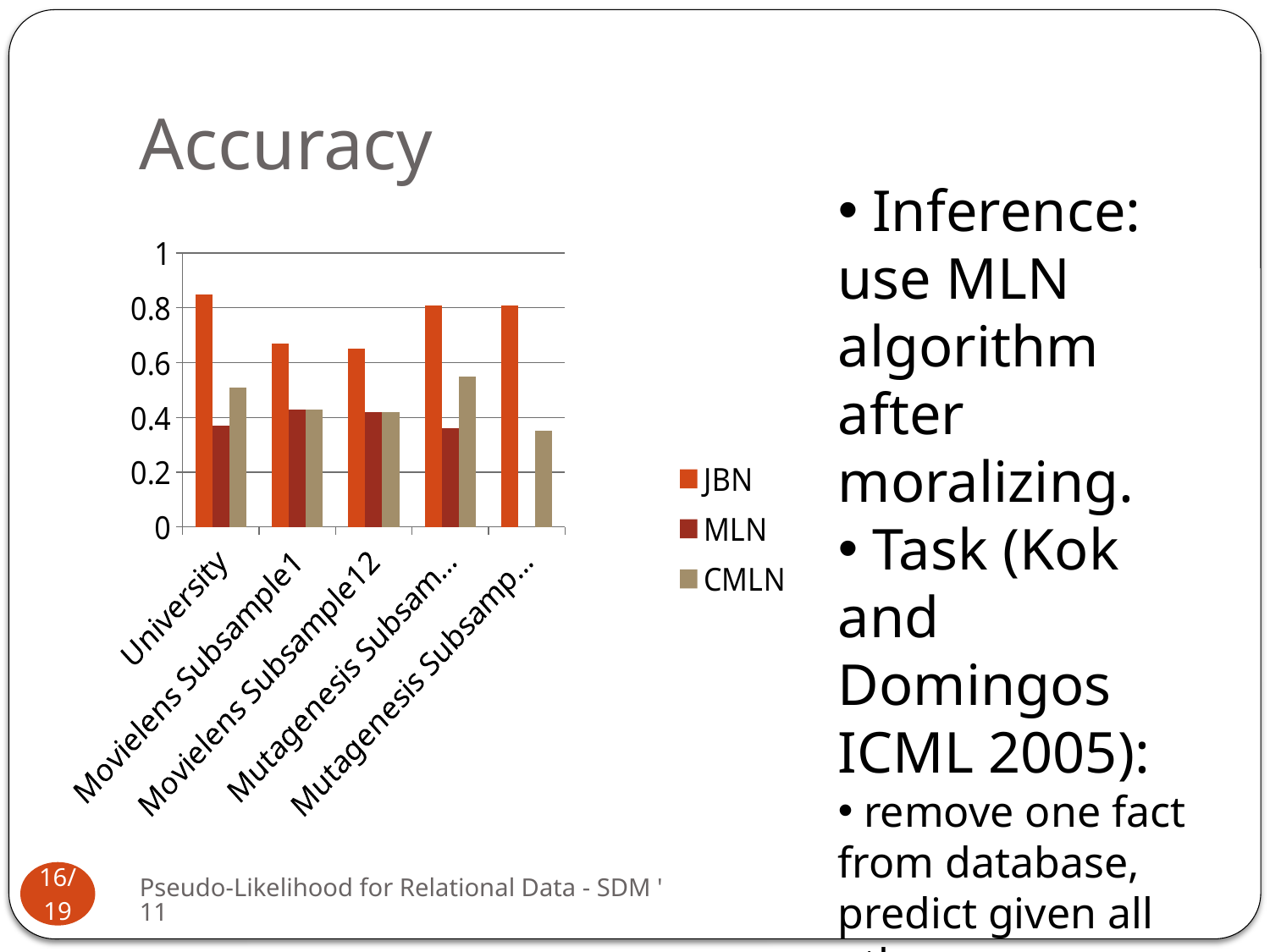
For University, which is larger, the JBN value or the MLN value? JBN Which series are listed in the legend? JBN, MLN, CMLN Is the MLN value for University greater or less than 0.4? less Is the CMLN value for University greater or less than 0.4? greater For University, which is larger, the CMLN value or the MLN value? CMLN What is the title of the chart? Accuracy Is the MLN value for Movielens Subsample12 greater or less than 0.6? less What kind of chart is shown on the slide? bar chart How many series does the legend list? 3 How many categories are shown on the x axis of the chart? 5